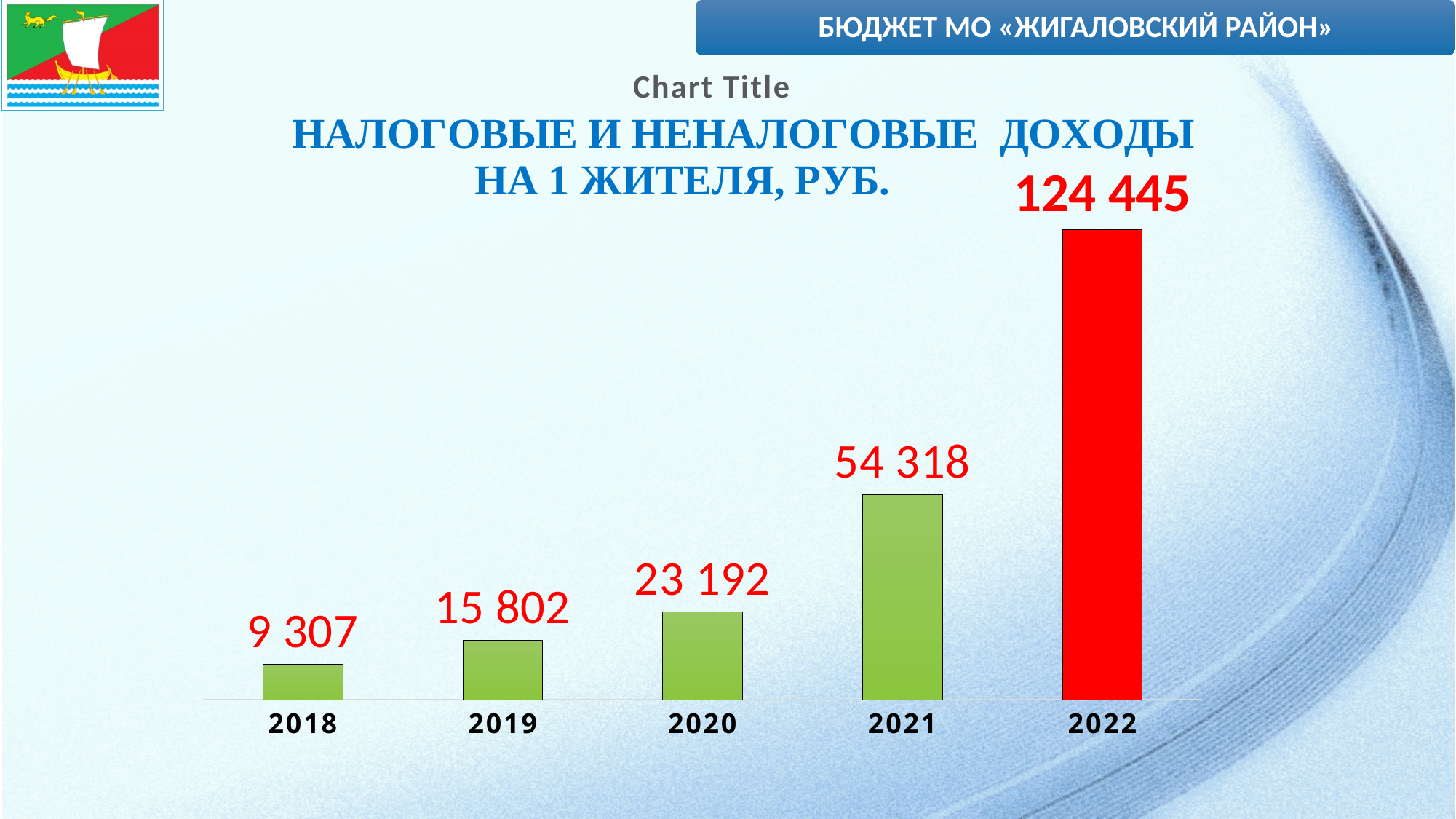
Which year has the highest value? 2022 Which is larger, the value for 2020 or the value for 2021? 2021 What is the value shown for 2022? 124 445 What is the difference between the values for 2019 and 2018? 6 495 Which year has the lowest value? 2018 What is the value shown for 2020? 23 192 How many years are shown on the x axis? 5 Do the values rise or fall from 2018 to 2022? Rise What kind of chart is shown on the slide? Bar chart What is the value shown for 2021? 54 318 What is the value shown for 2018? 9 307 What is the difference between the values for 2022 and 2021? 70 127